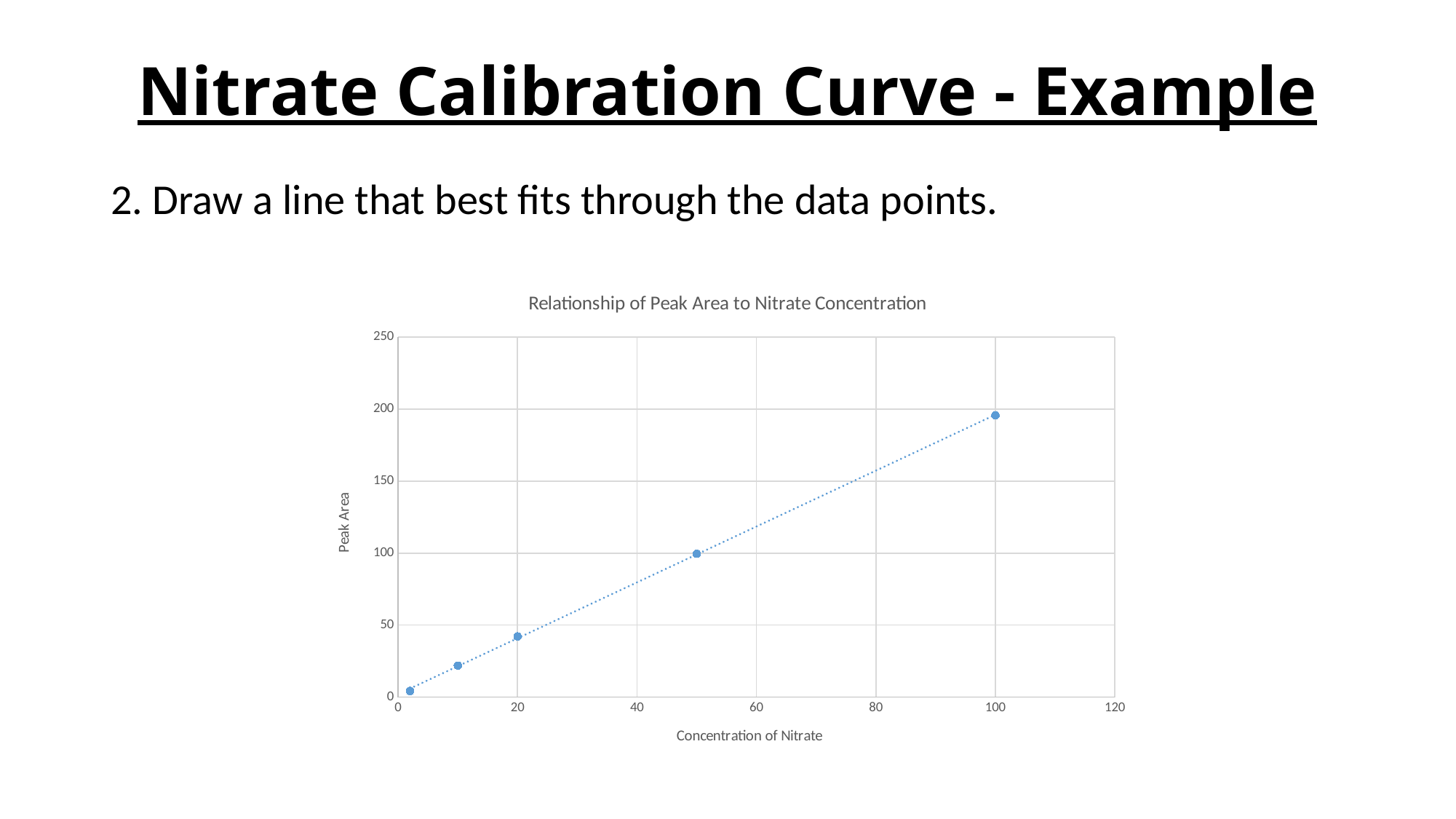
What is the title of the chart? Relationship of Peak Area to Nitrate Concentration Is the Peak Area for the data point at a concentration of 10 greater or less than 50? less Is the Peak Area for the data point at a concentration of 100 greater or less than 150? greater Which has the larger Peak Area: the data point at a concentration of 50 or the data point at a concentration of 20? The data point at a concentration of 50 Do the Peak Area values rise or fall as Concentration of Nitrate increases? Rise How many data points are plotted on the chart? 5 At which Concentration of Nitrate is the Peak Area highest? 100 What is the label of the vertical axis? Peak Area Is the Peak Area for the data point at a concentration of 20 greater or less than 50? less What kind of chart is shown on the slide? Scatter chart What is the highest value shown on the vertical axis of the chart? 250